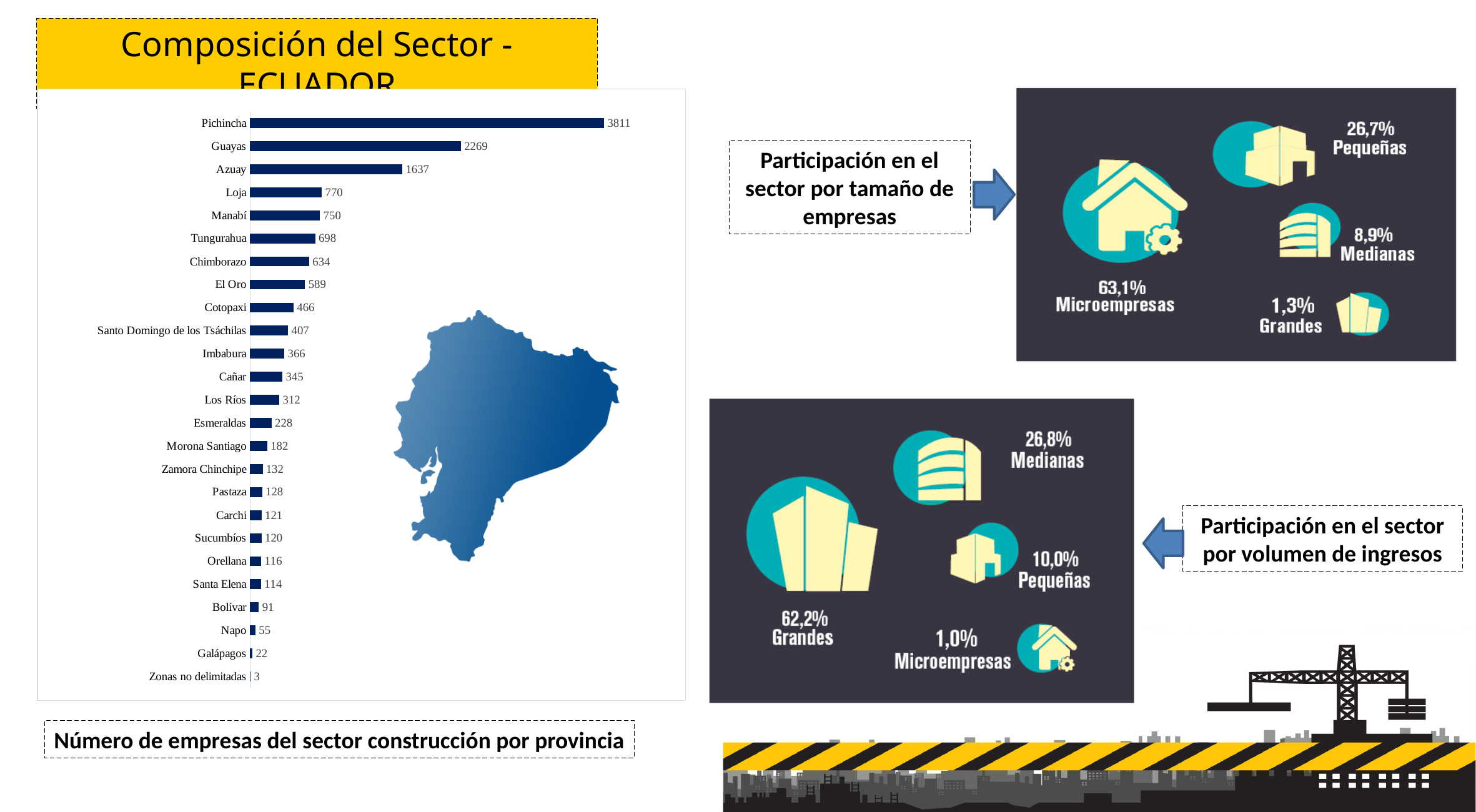
In the bar chart of companies by province, what is the difference between Pichincha and Guayas? 1542 How many categories are shown in the bar chart of companies by province? 25 In the bar chart of companies by province, what is the value for Pichincha? 3811 In the bar chart of companies by province, what is the value for Azuay? 1637 Which category has the lowest value in the bar chart of companies by province? Zonas no delimitadas In the bar chart of companies by province, what is the difference between Loja and Manabí? 20 In the bar chart of companies by province, what is the value for Santo Domingo de los Tsáchilas? 407 What type of chart is used to show the number of construction companies by province? Bar chart In the bar chart of companies by province, which is larger, Cotopaxi or Imbabura? Cotopaxi What is the caption below the bar chart of companies by province? Número de empresas del sector construcción por provincia In the bar chart of companies by province, what is the value for Galápagos? 22 Which province has the highest number of construction companies in the bar chart? Pichincha